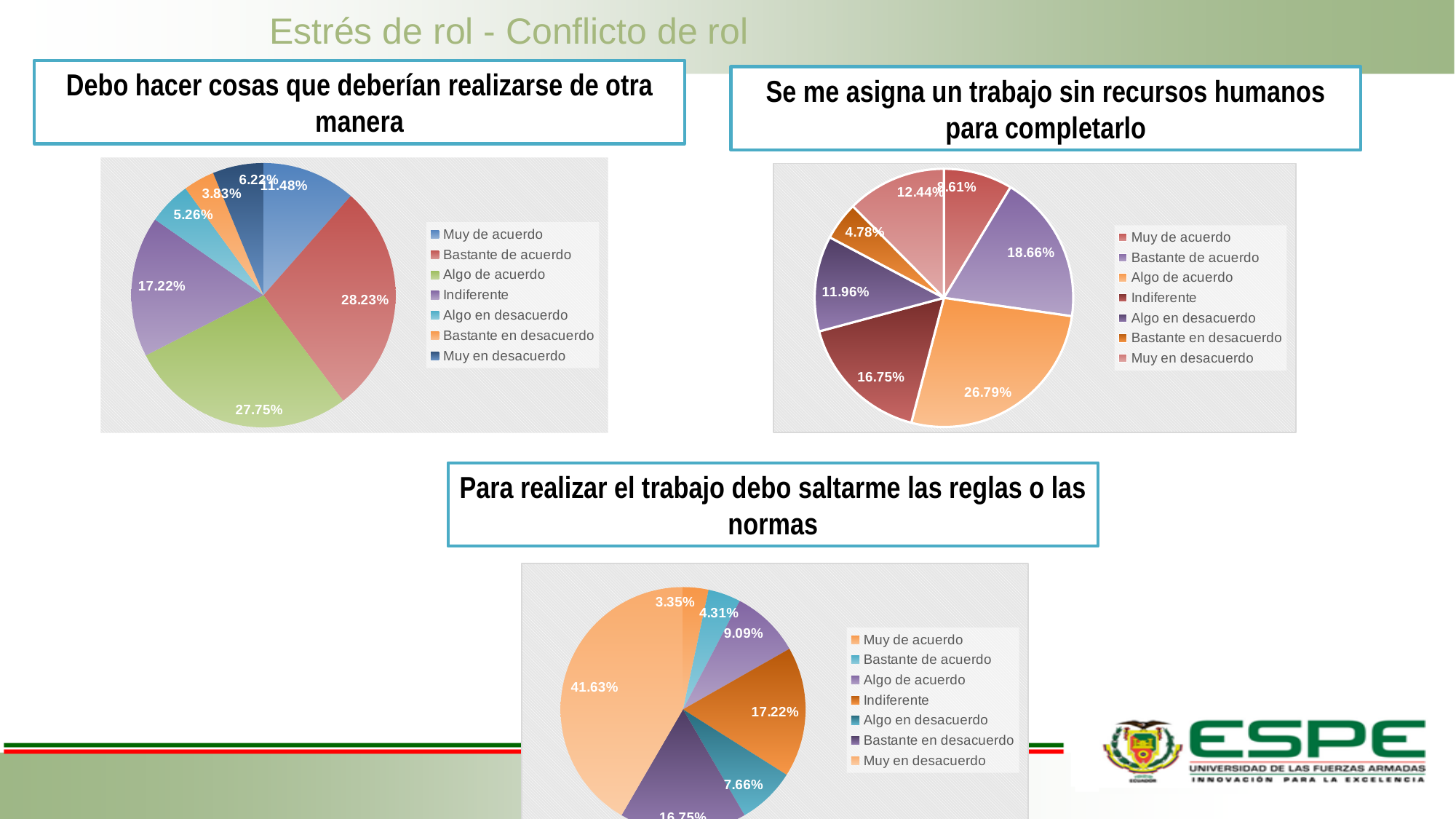
In the chart titled 'Debo hacer cosas que deberían realizarse de otra manera', what percentage is shown for 'Bastante de acuerdo'? 28.23% In the chart titled 'Se me asigna un trabajo sin recursos humanos para completarlo', what percentage is shown for 'Algo de acuerdo'? 26.79% In the chart titled 'Para realizar el trabajo debo saltarme las reglas o las normas', what is the largest percentage shown on the pie? 41.63% In the chart titled 'Se me asigna un trabajo sin recursos humanos para completarlo', which is larger: 'Bastante de acuerdo' or 'Indiferente'? Bastante de acuerdo How many categories does the legend list in the chart titled 'Para realizar el trabajo debo saltarme las reglas o las normas'? 7 In the chart titled 'Se me asigna un trabajo sin recursos humanos para completarlo', what percentage is shown for 'Algo en desacuerdo'? 11.96% In the chart titled 'Debo hacer cosas que deberían realizarse de otra manera', what percentage is shown for 'Indiferente'? 17.22% In the chart titled 'Para realizar el trabajo debo saltarme las reglas o las normas', what percentage is shown for 'Indiferente'? 17.22% What type of chart is used for 'Debo hacer cosas que deberían realizarse de otra manera'? Pie chart In the chart titled 'Debo hacer cosas que deberían realizarse de otra manera', which category has the smallest share? Bastante en desacuerdo In the chart titled 'Debo hacer cosas que deberían realizarse de otra manera', what is the difference between 'Bastante de acuerdo' and 'Algo de acuerdo'? 0.48% In the chart titled 'Se me asigna un trabajo sin recursos humanos para completarlo', which category has the largest share? Algo de acuerdo